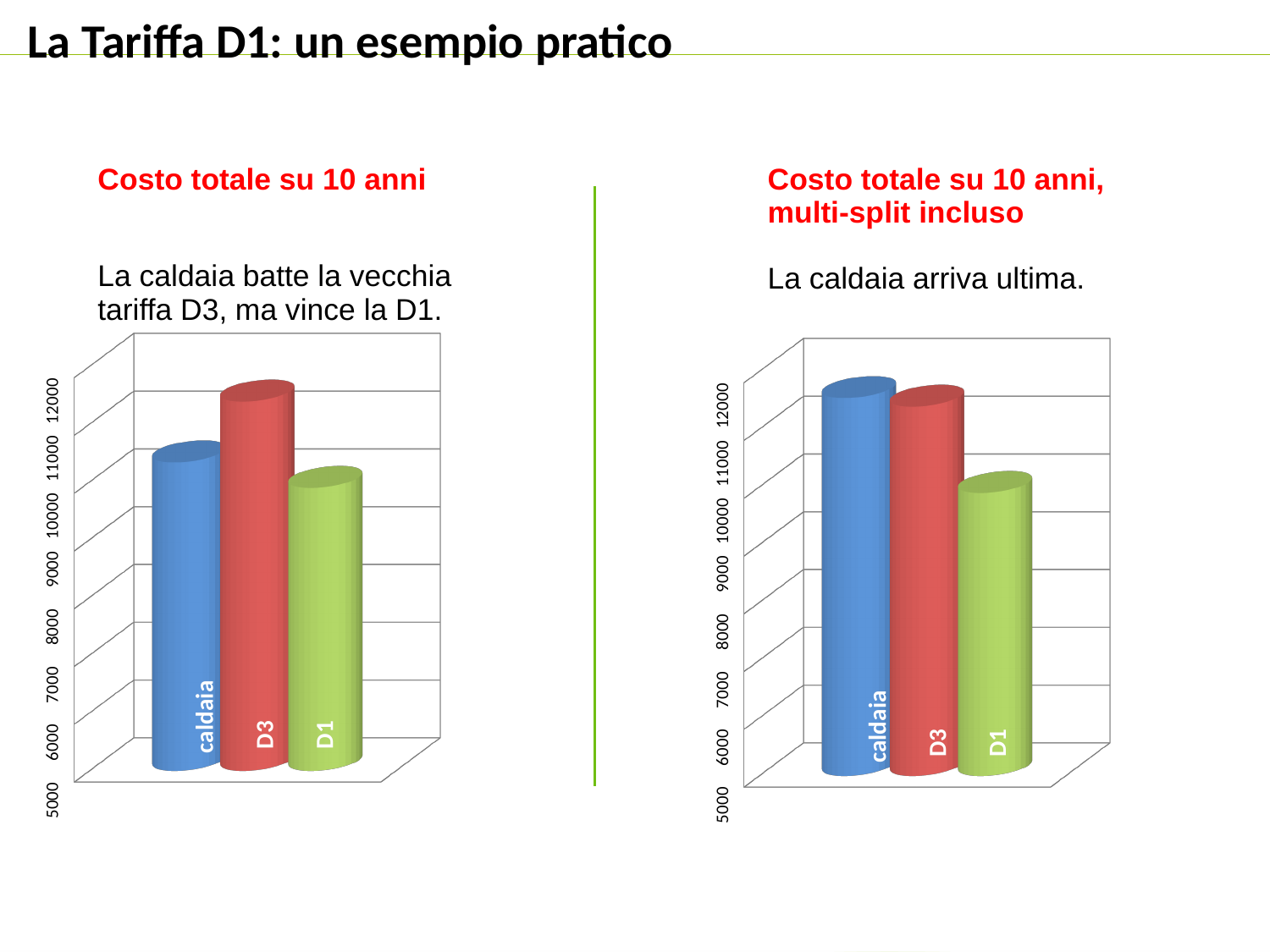
In the right chart, 'Costo totale su 10 anni, multi-split incluso', which is larger, the value for D1 or the value for D3? D3 What is the title of the right chart? Costo totale su 10 anni, multi-split incluso In the right chart, 'Costo totale su 10 anni, multi-split incluso', which category has the highest value? caldaia In the left chart, 'Costo totale su 10 anni', is the value for D1 greater or less than 8000? greater In the left chart, 'Costo totale su 10 anni', is the value for D3 greater or less than 10000? greater What kind of chart is the left chart, 'Costo totale su 10 anni'? bar chart In the left chart, 'Costo totale su 10 anni', which category has the highest value? D3 In the right chart, 'Costo totale su 10 anni, multi-split incluso', which category has the lowest value? D1 How many bars are shown in the left chart, 'Costo totale su 10 anni'? 3 In the left chart, 'Costo totale su 10 anni', which category has the lowest value? D1 In the right chart, 'Costo totale su 10 anni, multi-split incluso', is the value for caldaia greater or less than 11000? greater In the left chart, 'Costo totale su 10 anni', which is larger, the value for caldaia or the value for D3? D3